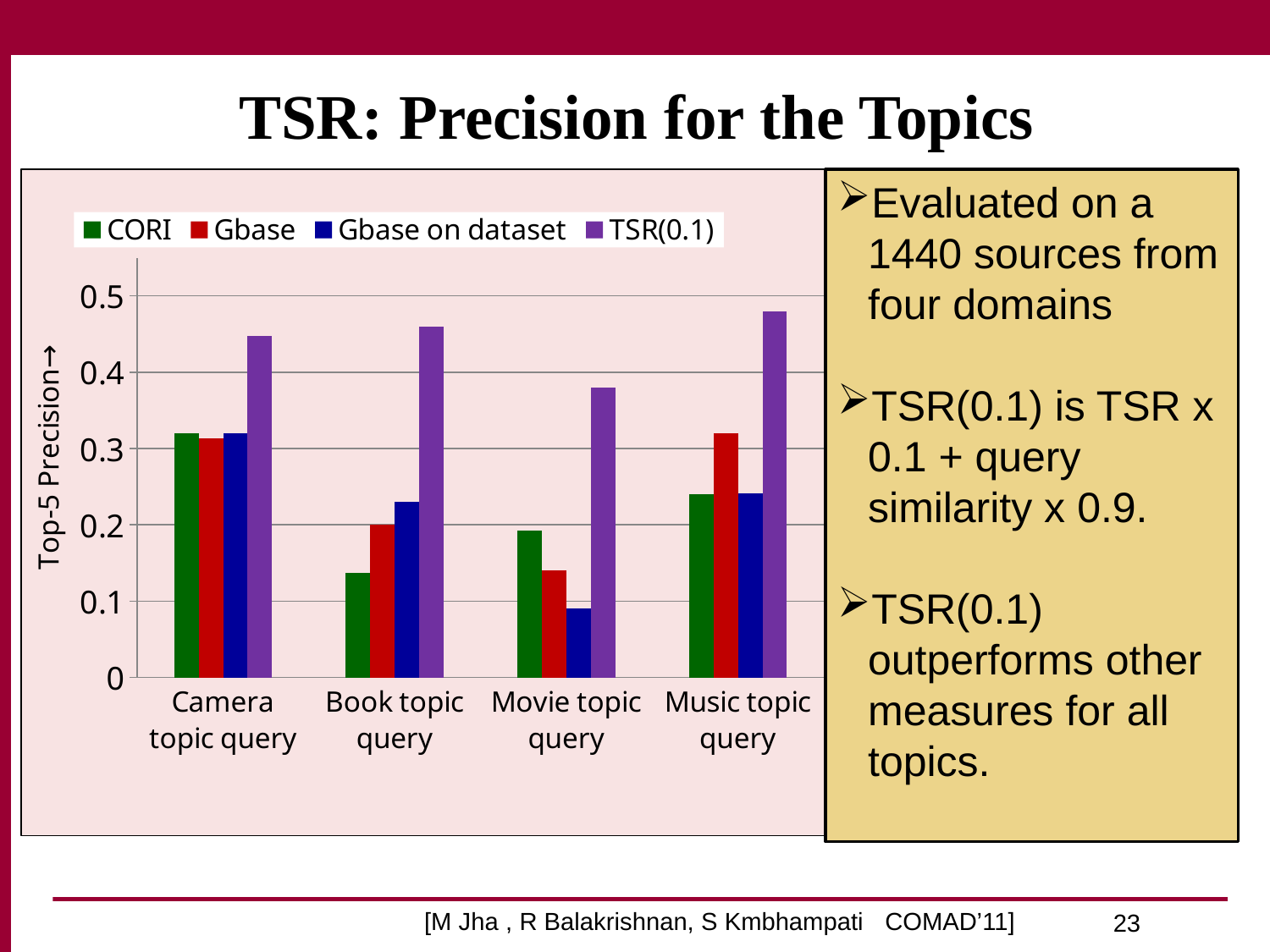
Is the TSR(0.1) value for the Camera topic query greater or less than 0.4? greater For the Music topic query, which is larger: the Gbase value or the Gbase on dataset value? Gbase How many series does the legend list? 4 How many topic query categories are shown on the x axis? 4 What is the label on the y axis of the chart? Top-5 Precision For the Movie topic query, which series has the lowest Top-5 Precision? Gbase on dataset Is the CORI value for the Book topic query greater or less than 0.2? less What kind of chart is shown on the slide? Bar chart Is the Gbase on dataset value for the Movie topic query greater or less than 0.1? less For the Book topic query, which is larger: the Gbase value or the CORI value? Gbase For the Music topic query, which series has the highest Top-5 Precision? TSR(0.1) Across the four topic queries, which one has the lowest TSR(0.1) value? Movie topic query